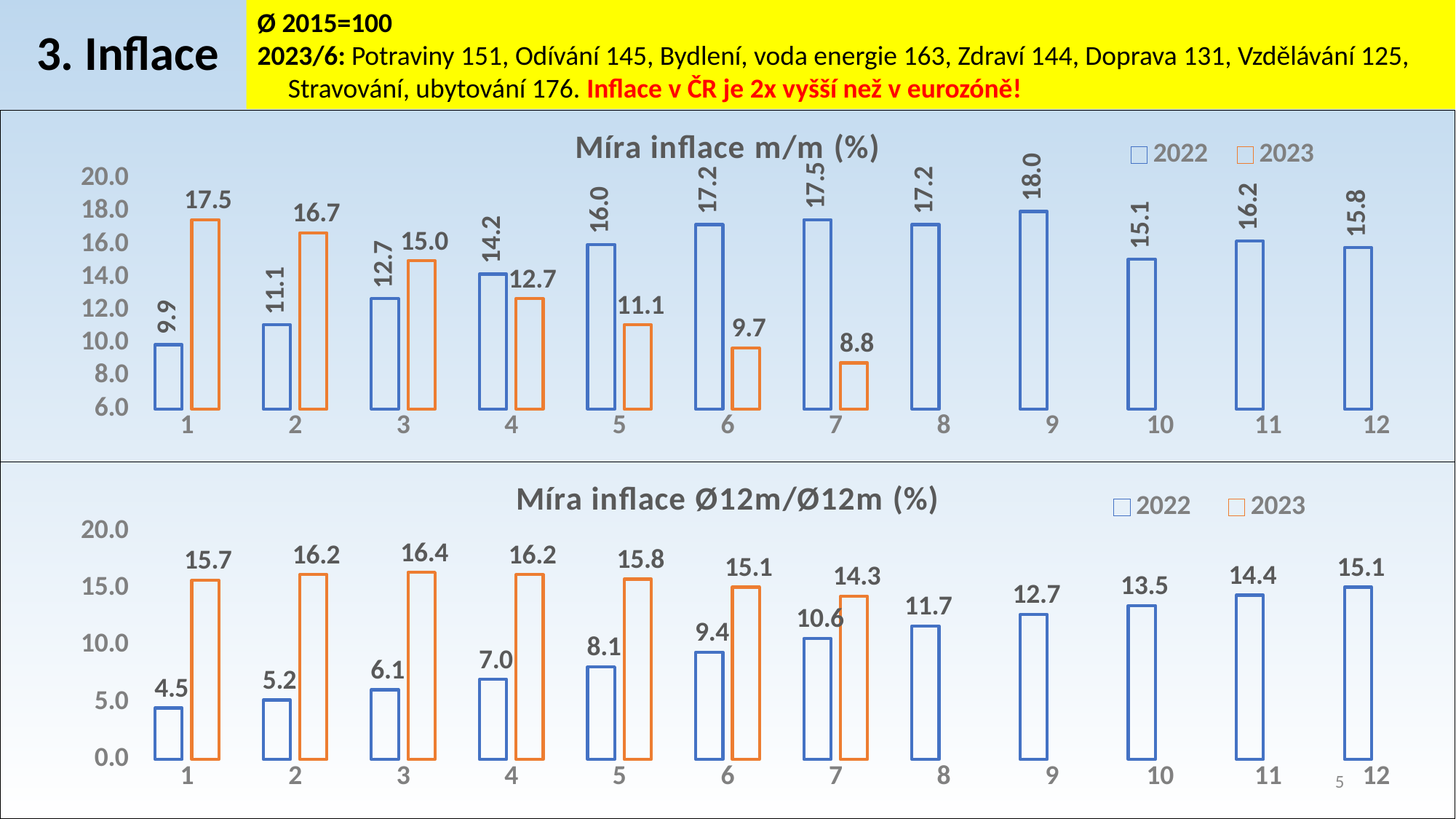
In the bottom chart 'Míra inflace Ø12m/Ø12m (%)', what is the 2022 value for month 12? 15.1 In the top chart 'Míra inflace m/m (%)', which month has the lowest 2023 value? 7 What kind of chart is the top chart 'Míra inflace m/m (%)'? bar chart In the top chart 'Míra inflace m/m (%)', what is the difference between the 2023 and 2022 values for month 1? 7.6 In the top chart 'Míra inflace m/m (%)', what is the 2022 value for month 9? 18.0 In the bottom chart 'Míra inflace Ø12m/Ø12m (%)', which month has the highest 2023 value? 3 In the top chart 'Míra inflace m/m (%)', how many months have a 2023 bar? 7 How many series does the legend of the bottom chart 'Míra inflace Ø12m/Ø12m (%)' list? 2 In the top chart 'Míra inflace m/m (%)', what is the 2023 value for month 1? 17.5 In the bottom chart 'Míra inflace Ø12m/Ø12m (%)', which is larger for month 6: the 2022 value or the 2023 value? 2023 In the top chart 'Míra inflace m/m (%)', which month has the highest 2022 value? 9 In the bottom chart 'Míra inflace Ø12m/Ø12m (%)', do the 2022 values rise or fall from month 1 to month 12? rise